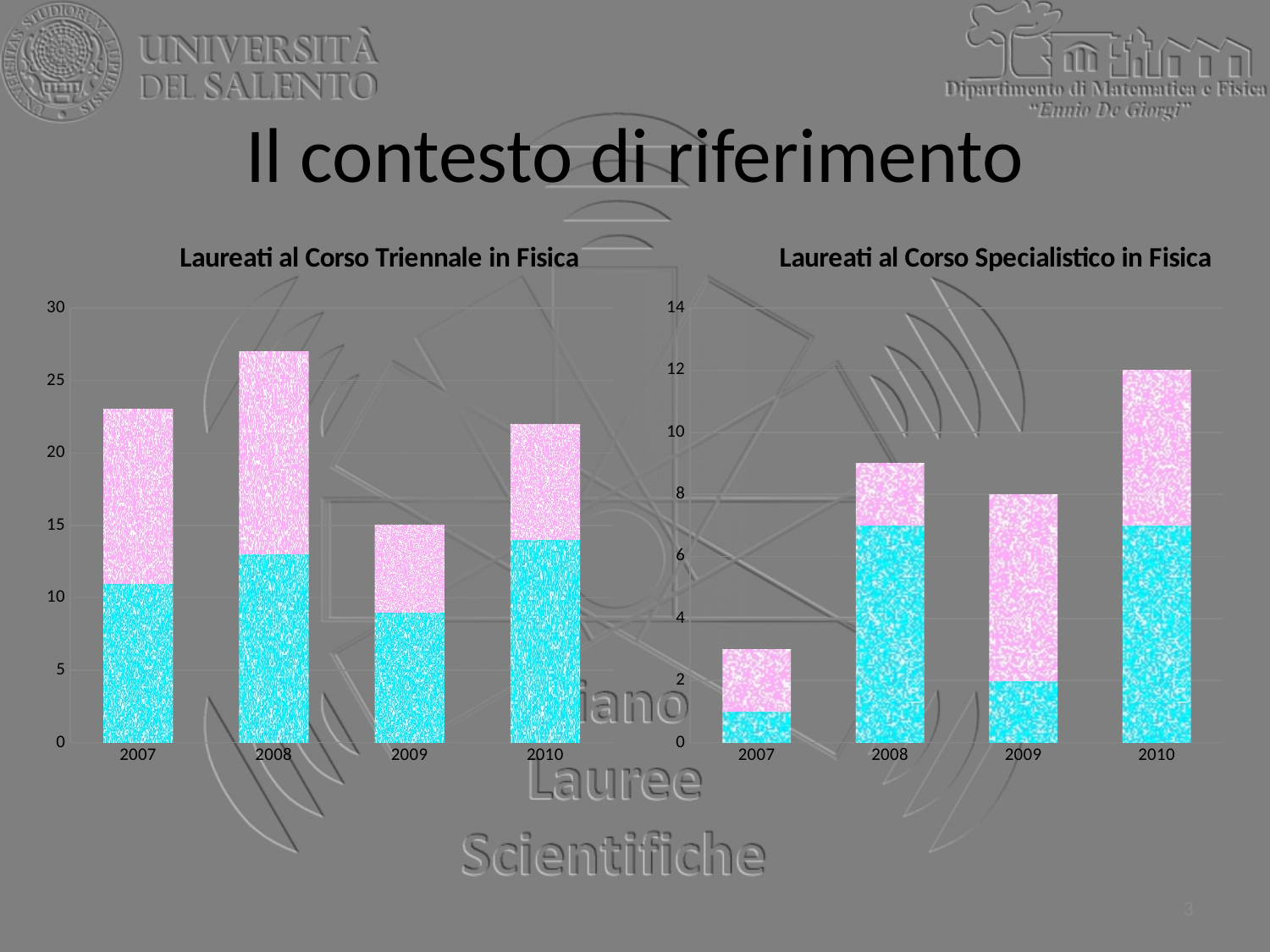
In the 'Laureati al Corso Specialistico in Fisica' chart, which year has the shortest bar? 2007 In the 'Laureati al Corso Triennale in Fisica' chart, is the total bar height for 2009 greater or less than 20? less What is the title of the chart on the right side of the slide? Laureati al Corso Specialistico in Fisica In the 'Laureati al Corso Triennale in Fisica' chart, which year has the tallest bar? 2008 In the 'Laureati al Corso Triennale in Fisica' chart, how many years are shown on the x axis? 4 In the 'Laureati al Corso Triennale in Fisica' chart, is the total bar height for 2007 greater or less than 20? greater In the 'Laureati al Corso Specialistico in Fisica' chart, is the total bar height for 2007 greater or less than 4? less In the 'Laureati al Corso Triennale in Fisica' chart, which year has the shortest bar? 2009 In the 'Laureati al Corso Specialistico in Fisica' chart, which year has the tallest bar? 2010 In the 'Laureati al Corso Triennale in Fisica' chart, which bar is taller, 2007 or 2009? 2007 What kind of chart is the 'Laureati al Corso Triennale in Fisica' chart? bar chart